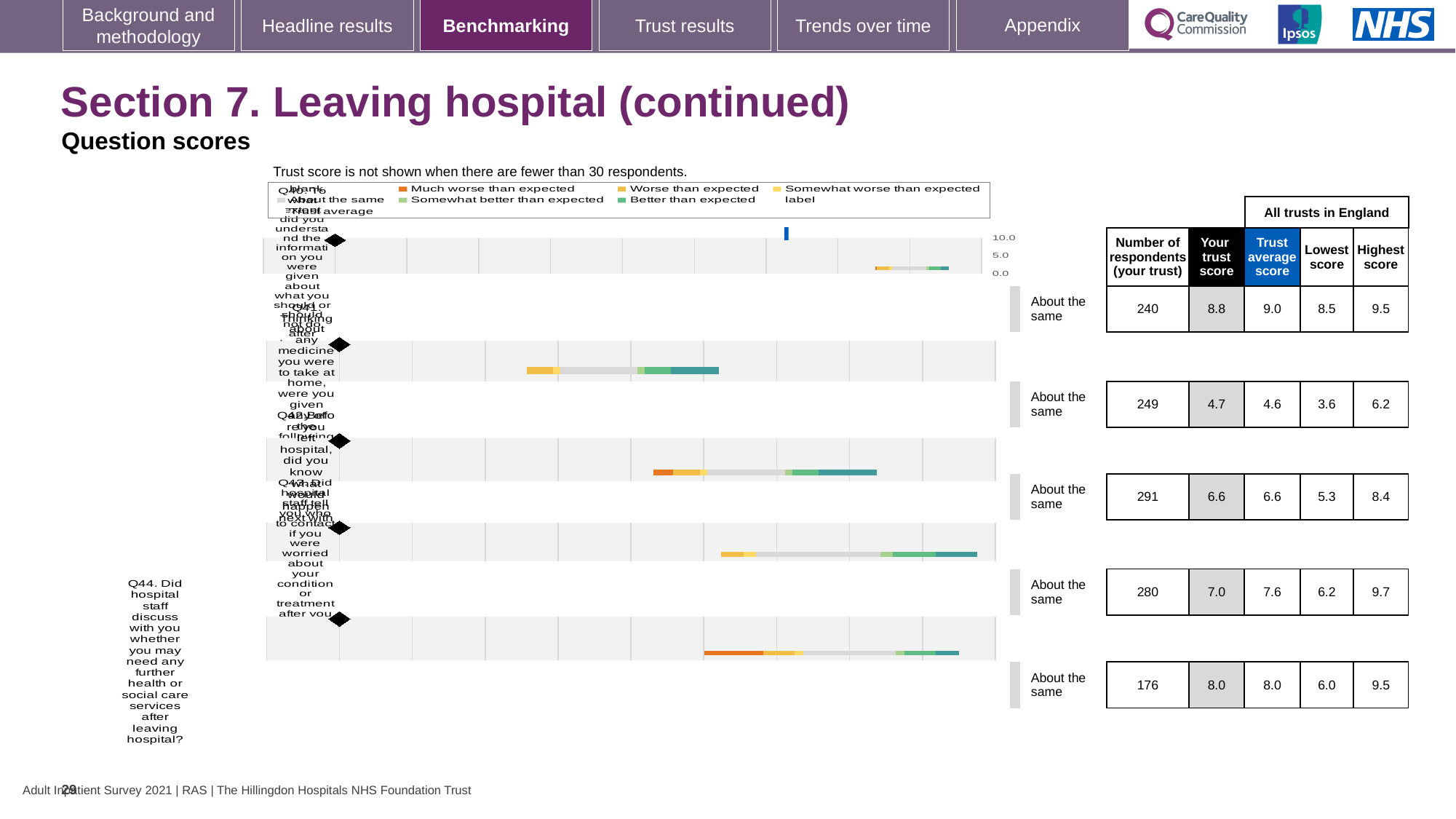
What is the largest number of respondents shown for any question in the table? 291 For the first question row (trust score 8.8), which is larger: the trust score or the trust average score? Trust average score What is the number of respondents for Q44 (further health or social care services after leaving hospital)? 176 What is the difference between the highest score and the lowest score for Q44? 3.5 How many questions (rows) are plotted in the chart? 5 What kind of chart is used to show the question scores on this slide? bar chart What is the trust's score for Q44? 8.0 What benchmark category is shown for Q44? About the same According to the note above the chart, when is the trust score not shown? When there are fewer than 30 respondents What is the lowest 'Your trust score' shown in the table? 4.7 For the fourth question row, what is the difference between the trust average score (7.6) and the trust score (7.0)? 0.6 What is the highest score across all trusts in England for Q44? 9.5